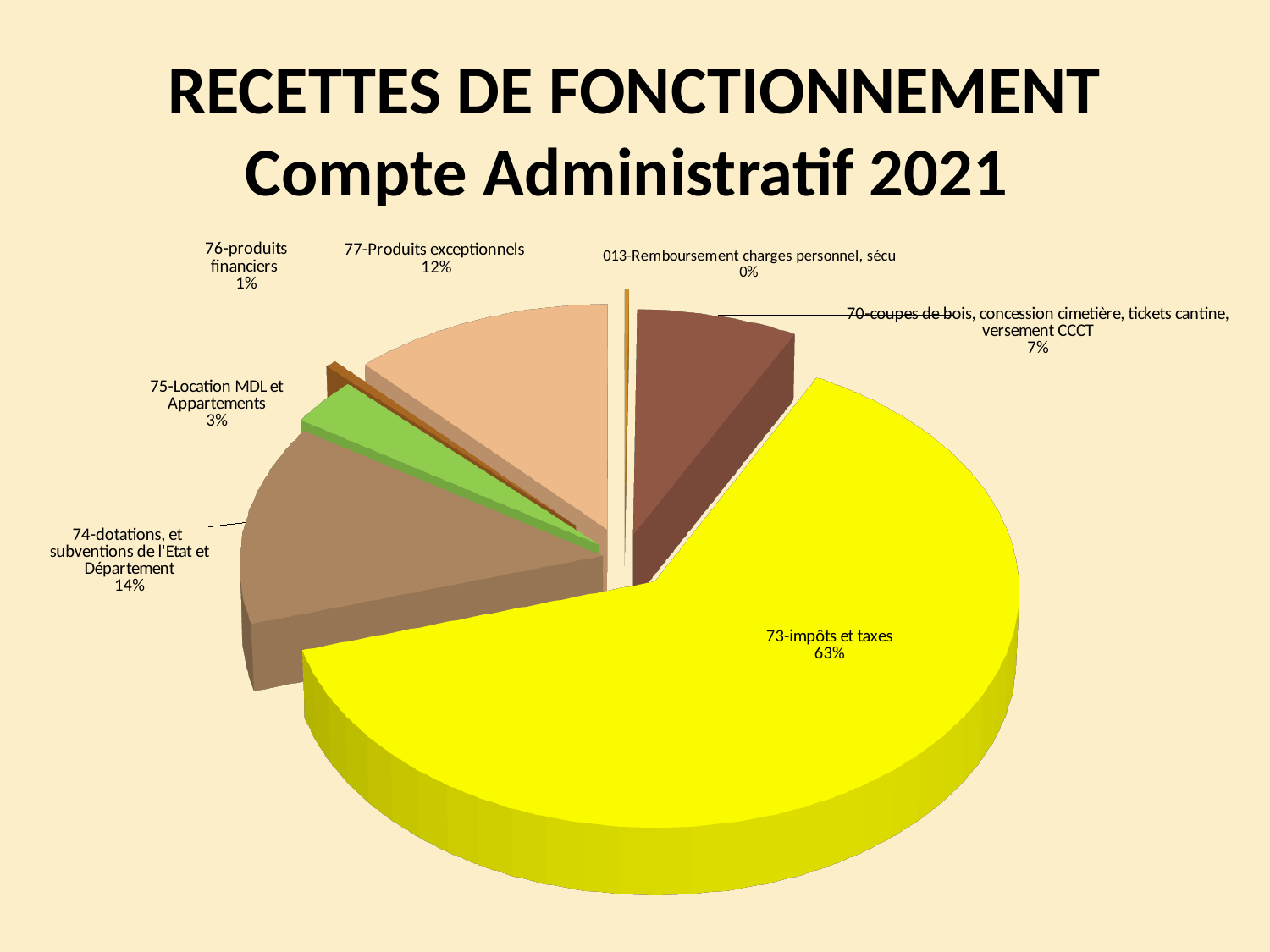
How many categories are shown in the pie chart? 7 Which category has the smallest slice of the pie? 013-Remboursement charges personnel, sécu What percentage is shown for 70-coupes de bois, concession cimetière, tickets cantine, versement CCCT? 7% What share of the pie does 73-impôts et taxes represent? 63% What percentage is shown for 74-dotations, et subventions de l'Etat et Département? 14% What is the difference in percentage points between 74-dotations, et subventions de l'Etat et Département and 77-Produits exceptionnels? 2 What percentage is shown for 75-Location MDL et Appartements? 3% Which is larger, 76-produits financiers or 75-Location MDL et Appartements? 75-Location MDL et Appartements What percentage is shown for 77-Produits exceptionnels? 12% Which category has the largest slice of the pie? 73-impôts et taxes What percentage is shown for 013-Remboursement charges personnel, sécu? 0% What type of chart is shown on the slide? Pie chart